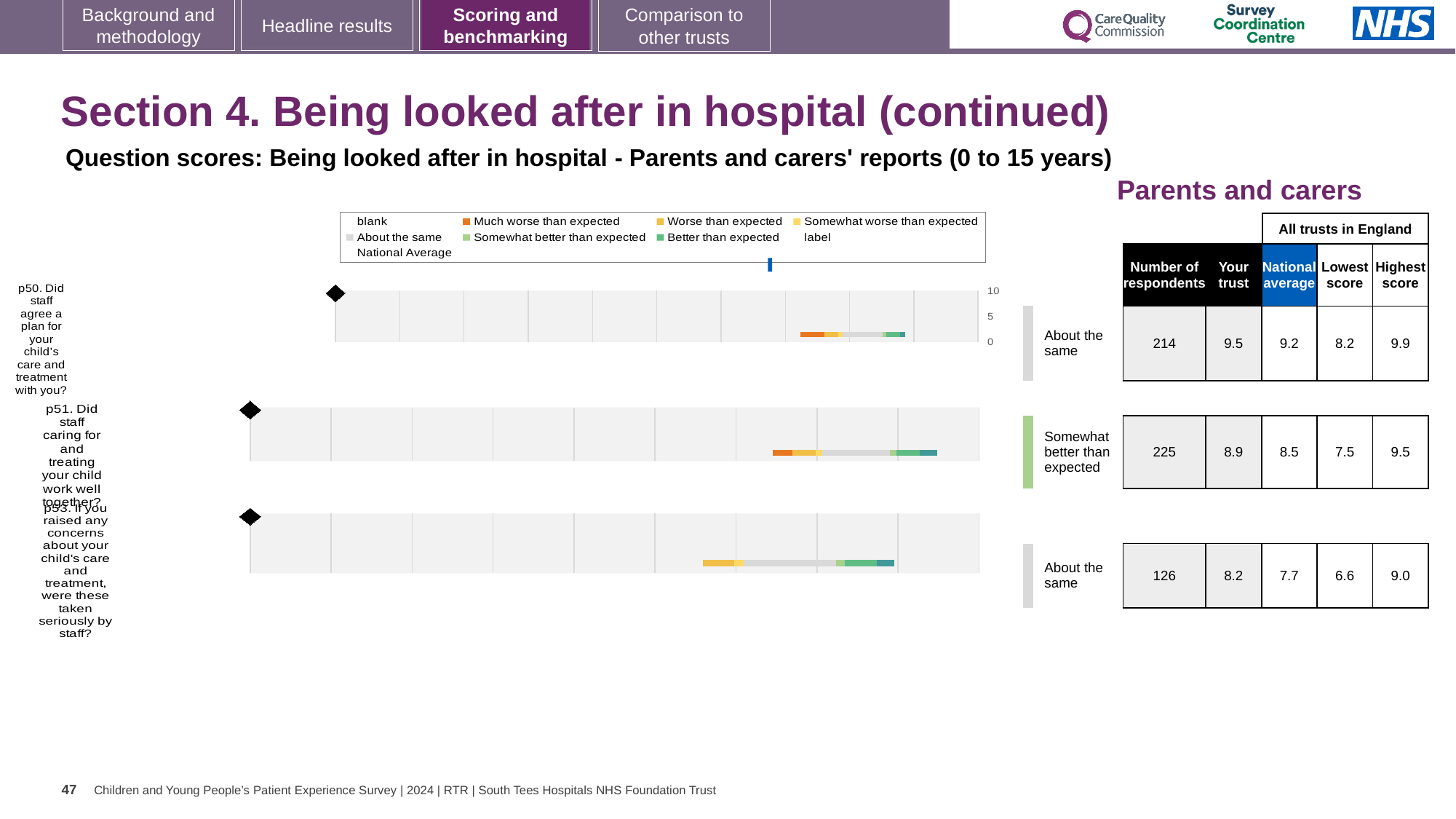
How many question charts are plotted on the slide? 3 What benchmark category is p51 rated as? Somewhat better than expected Which question has the lowest 'Your trust' score? p53 What is the lowest score among all trusts in England for p53? 6.6 What is the difference between the 'Your trust' score and the national average for p50? 0.3 Which question has the highest 'Your trust' score? p50 What is the maximum value shown on the vertical axis of the p50 chart? 10 For p51 (Did staff caring for and treating your child work well together?), what is the national average score? 8.5 Is the 'Your trust' score higher for p51 or for p53? p51 What is the highest score among all trusts in England for p50? 9.9 For p53 (If you raised any concerns about your child's care and treatment, were these taken seriously by staff?), how many respondents were there? 126 For p50 (Did staff agree a plan for your child's care and treatment with you?), what is the 'Your trust' score? 9.5